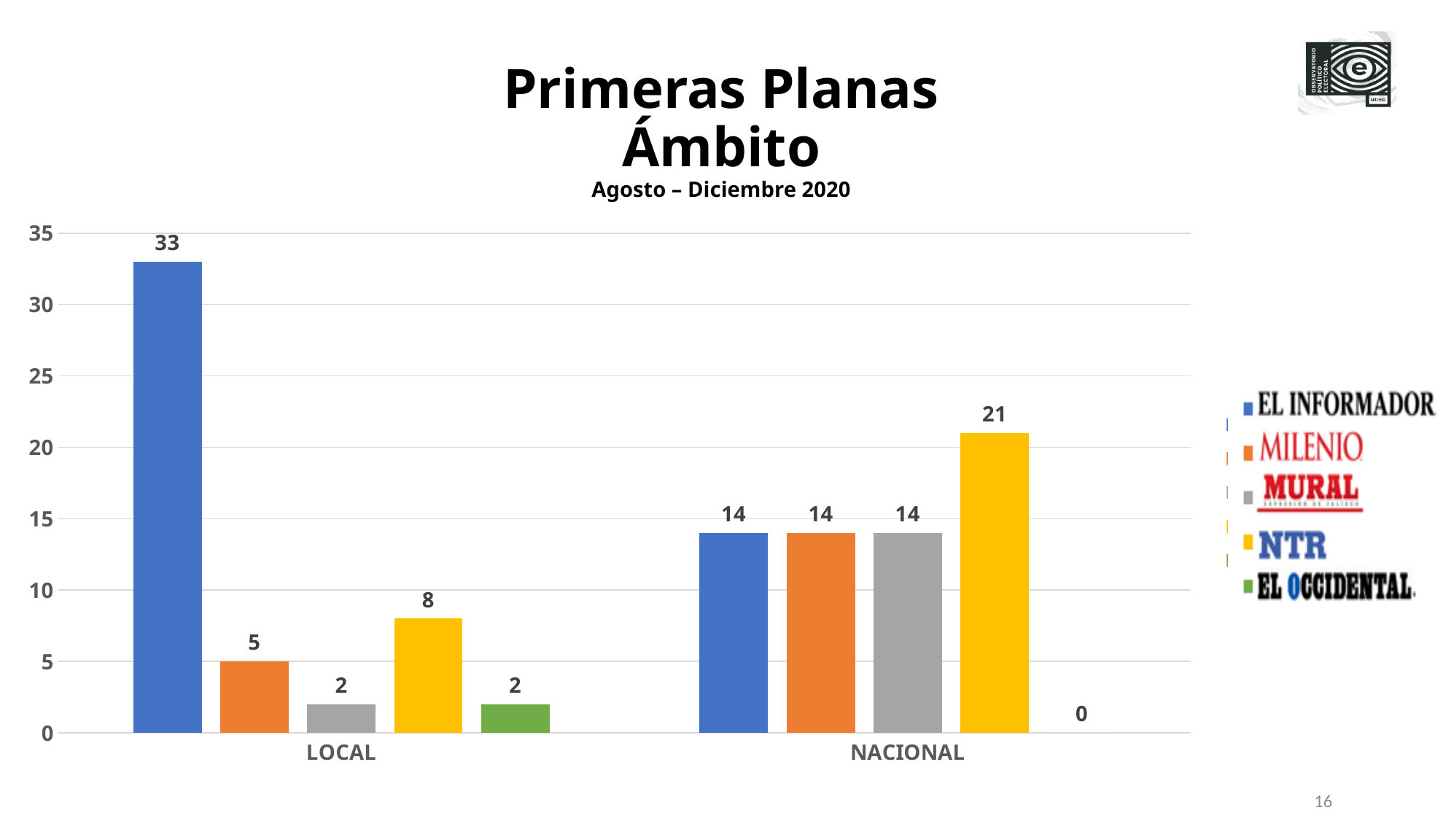
What is the value for Milenio in the LOCAL category? 5 What kind of chart is shown on the slide? Bar chart What is the difference between El Informador's LOCAL value and its NACIONAL value? 19 How many categories are shown on the x axis? 2 What is the value for NTR in the NACIONAL category? 21 Which newspaper has the highest value in the NACIONAL category? NTR What is the value for El Informador in the LOCAL category? 33 How many series does the legend list? 5 Which newspaper has the highest value in the LOCAL category? El Informador Which is larger: NTR's LOCAL value or Milenio's LOCAL value? NTR's LOCAL value What is the value for El Occidental in the NACIONAL category? 0 What period does the chart subtitle cover? Agosto – Diciembre 2020